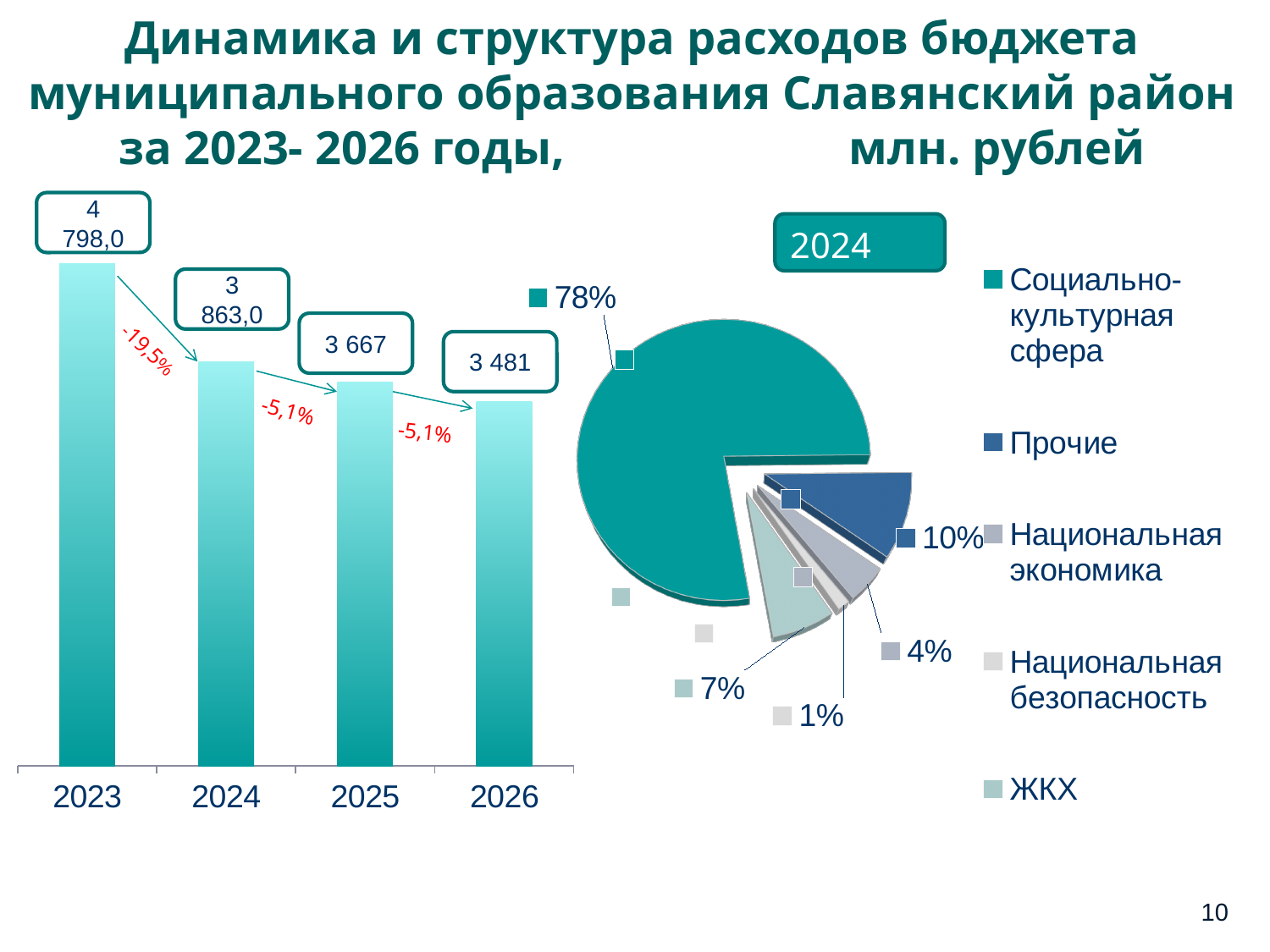
In the bar chart on the left, what percentage change is shown between 2023 and 2024? -19,5% In the pie chart titled 2024, which category has the smallest share? Национальная безопасность In the bar chart on the left, which year has the lowest value? 2026 In the pie chart titled 2024, what share does Социально-культурная сфера have? 78% In the bar chart on the left, which year has the highest value? 2023 In the pie chart titled 2024, how many categories does the legend list? 5 In the bar chart on the left, what is the value for 2023? 4 798,0 In the pie chart titled 2024, what share does ЖКХ have? 7% In the bar chart on the left, how many years are shown? 4 In the bar chart on the left, what is the value for 2026? 3 481 In the bar chart on the left, do the values rise or fall from 2023 to 2026? fall In the bar chart on the left, what is the difference between the values for 2023 and 2024? 935,0